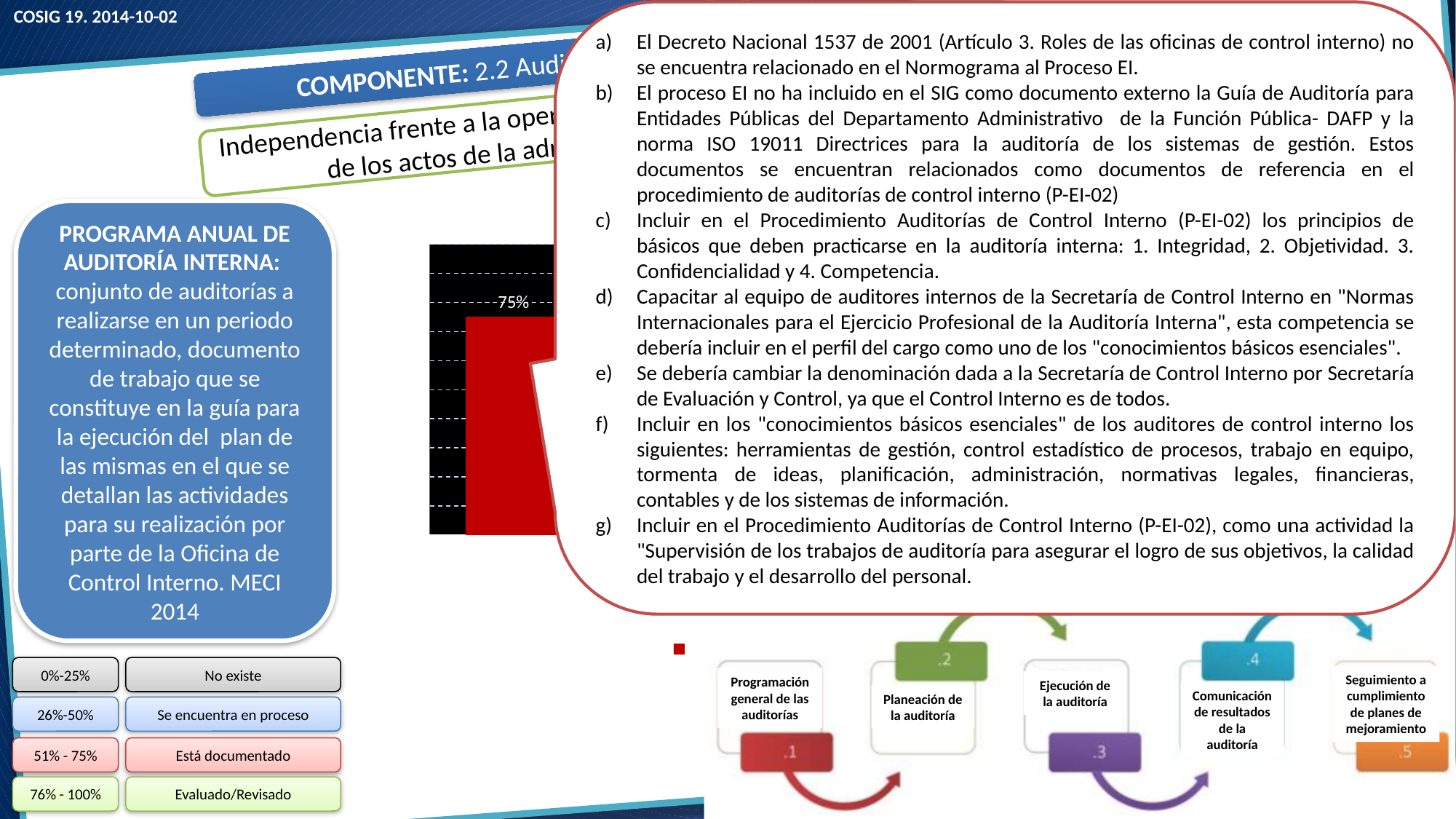
What colour is the bar in the chart? red What is the background colour of the chart's plot area? black What value is printed as the data label on the red bar in the chart? 75% Is the value shown on the red bar greater or less than 50%? greater What kind of chart is shown on the slide? bar chart